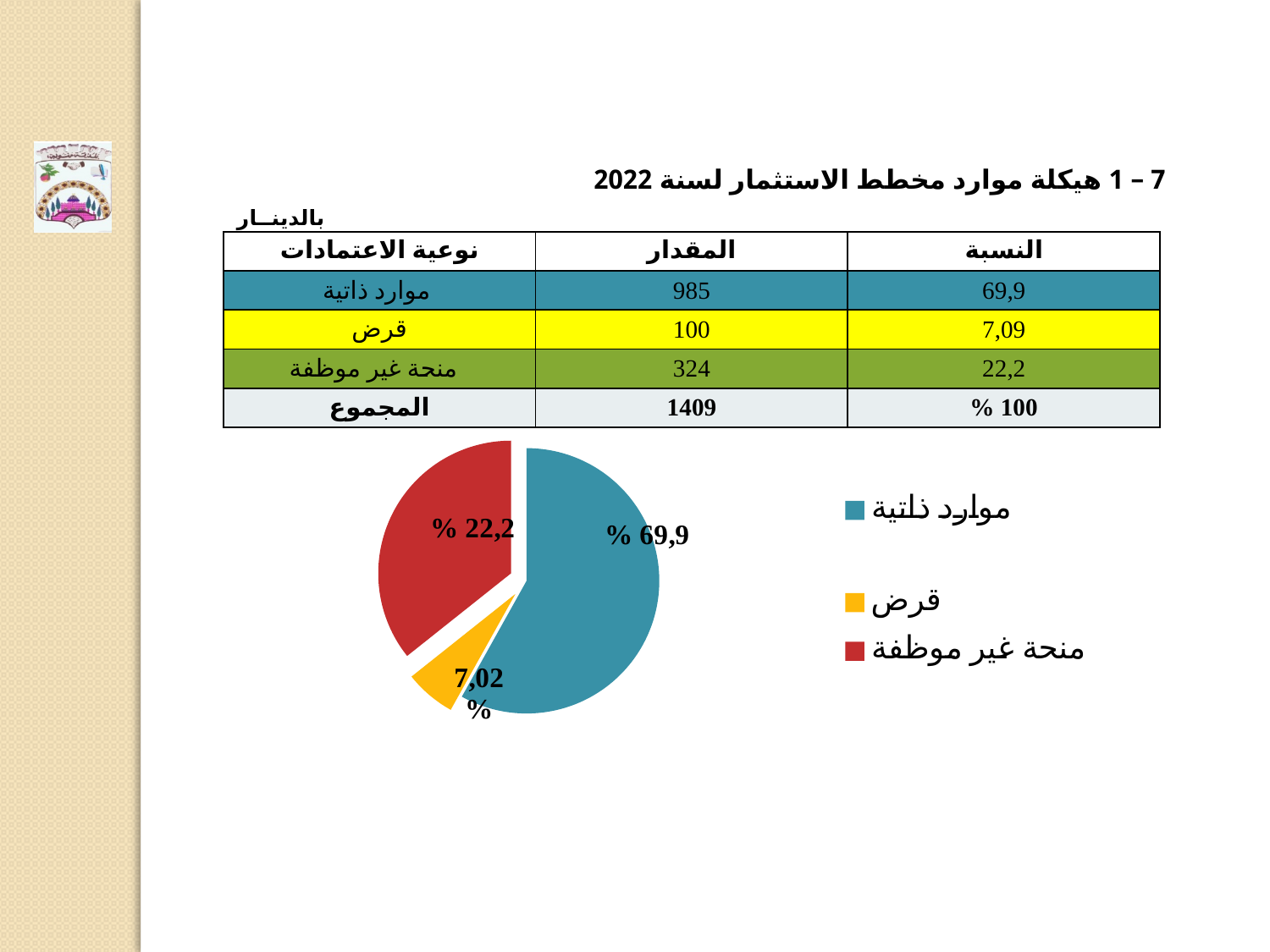
What percentage does the pie chart show for منحة غير موظفة? 22,2 % What percentage does the pie chart show for قرض? 7,02 % Which category has the largest slice in the pie chart? موارد ذاتية How many slices does the pie chart have? 3 What colour is the slice for منحة غير موظفة in the pie chart? red What kind of chart is shown on the slide? pie chart Which category has the smallest slice in the pie chart? قرض What is the difference in percentage points between the موارد ذاتية slice and the منحة غير موظفة slice in the pie chart? 47,7 What colour is the slice for قرض in the pie chart? yellow/orange In the pie chart, which is larger: the slice for منحة غير موظفة or the slice for قرض? منحة غير موظفة How many entries does the pie chart's legend list? 3 What percentage does the pie chart show for موارد ذاتية? 69,9 %